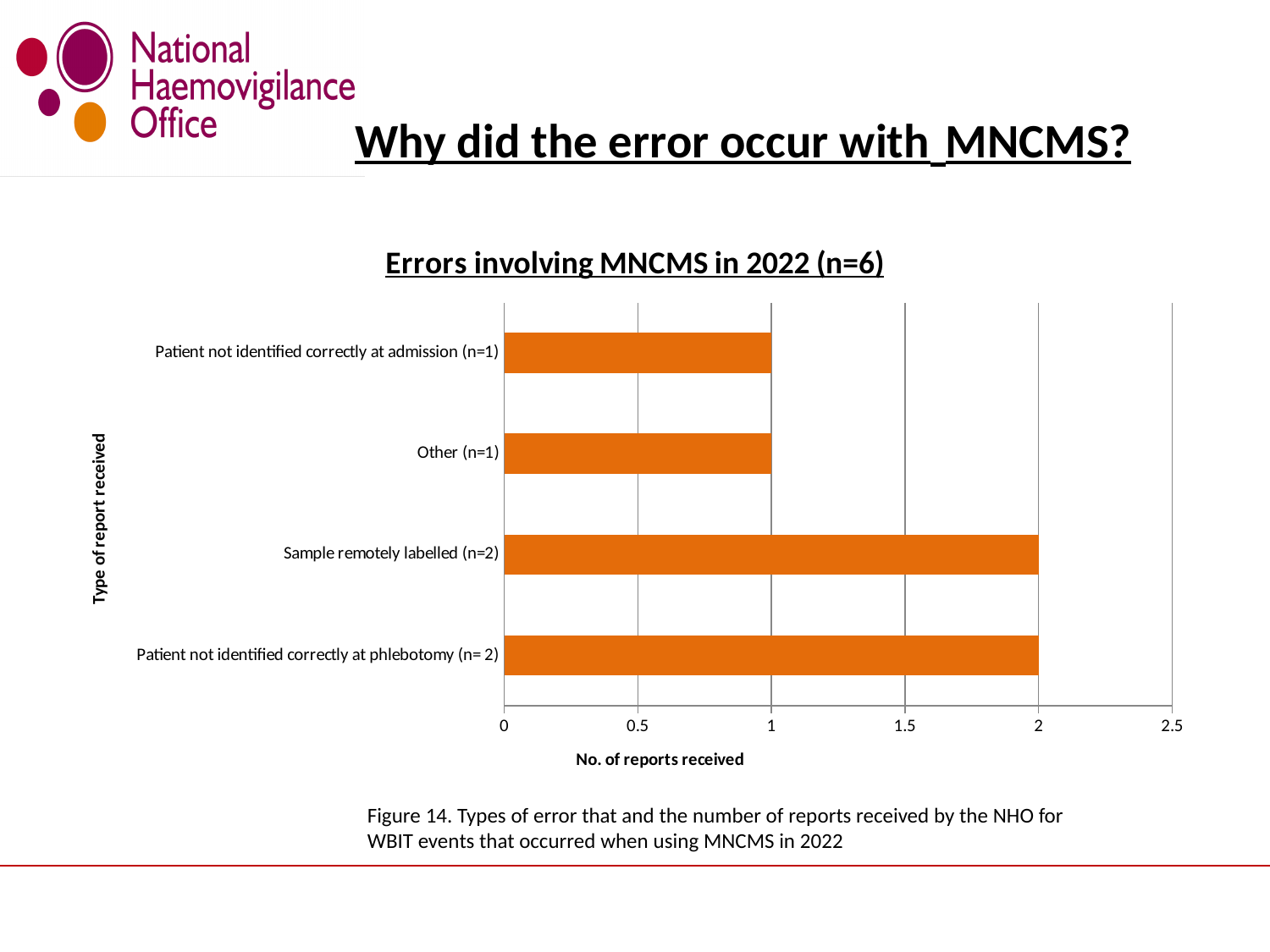
What is the label of the horizontal axis? No. of reports received How many types of report (categories) are shown in the chart? 4 What kind of chart is shown on the slide? Bar chart How many reports were received for 'Patient not identified correctly at phlebotomy'? 2 What is the total number of reports across all categories in the chart? 6 What is the difference in the number of reports between 'Patient not identified correctly at phlebotomy' and 'Patient not identified correctly at admission'? 1 How many reports were received for 'Other'? 1 How many reports were received for 'Patient not identified correctly at admission'? 1 What is the title of the chart? Errors involving MNCMS in 2022 (n=6) How many reports were received for 'Sample remotely labelled'? 2 Is the value for 'Other' greater or less than 1.5? less Which has more reports: 'Sample remotely labelled' or 'Other'? Sample remotely labelled